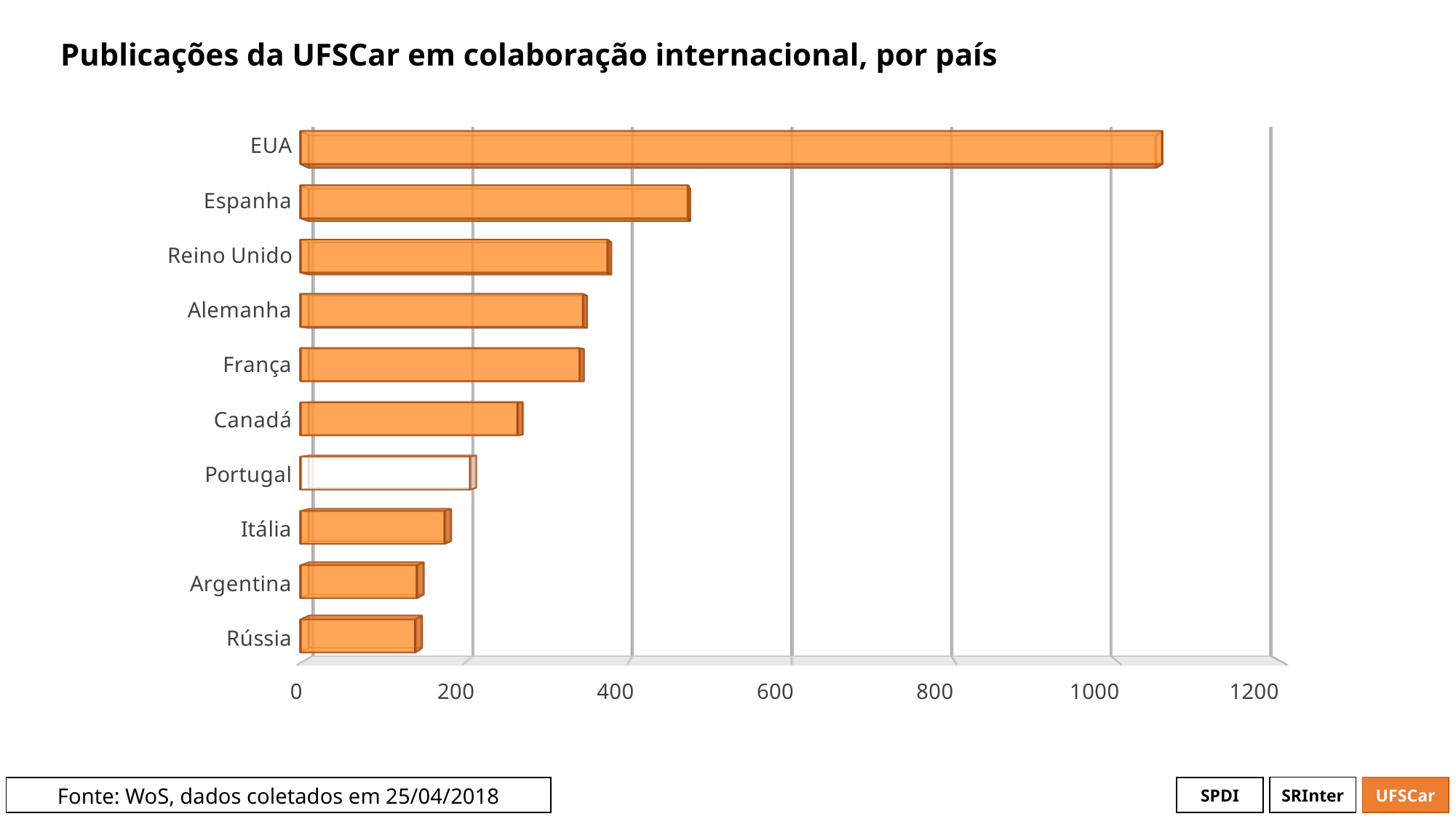
Which country has the highest number of publications in international collaboration with UFSCar? EUA Is the value for Alemanha greater or less than 400? less Is the value for Rússia greater or less than 200? less Is the value for Canadá greater or less than 200? greater Which country's bar is drawn in white instead of orange? Portugal Which has more publications, Canadá or Portugal? Canadá How many countries are shown in the chart? 10 Which has more publications, Espanha or Reino Unido? Espanha What kind of chart is shown on the slide? bar chart